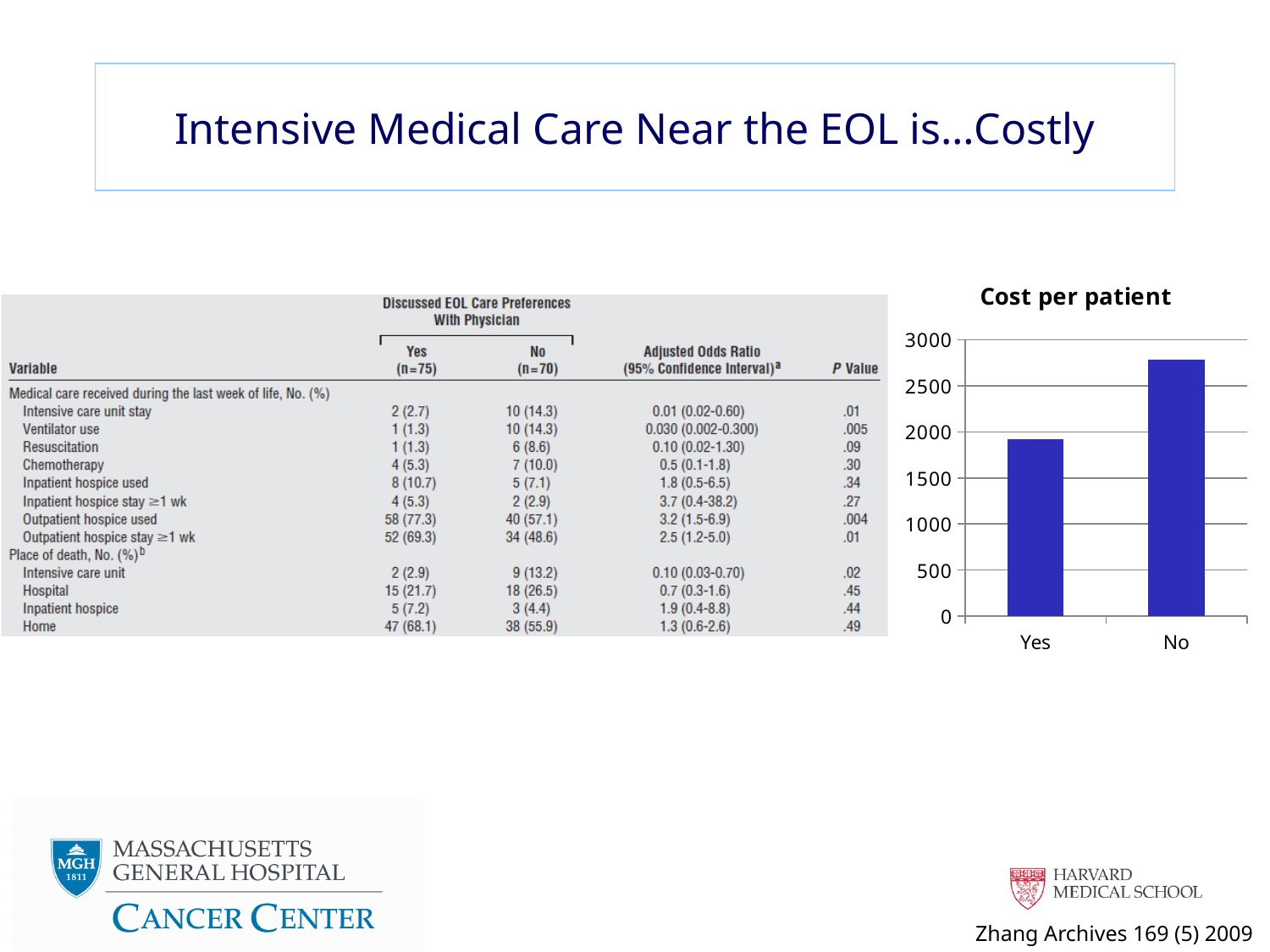
How many categories are shown on the x axis of the "Cost per patient" chart? 2 In the "Cost per patient" chart, is the value for Yes greater or less than 1500? greater Which category has the lowest cost per patient in the "Cost per patient" chart? Yes In the "Cost per patient" chart, is the value for Yes or No larger? No What kind of chart is the "Cost per patient" chart? bar chart What is the highest value labelled on the y axis of the "Cost per patient" chart? 3000 Which category has the highest cost per patient in the "Cost per patient" chart? No What is the title of the bar chart on the right of the slide? Cost per patient Do the values in the "Cost per patient" chart rise or fall from Yes to No? rise In the "Cost per patient" chart, is the value for No greater or less than 2500? greater In the "Cost per patient" chart, is the value for No greater or less than 3000? less